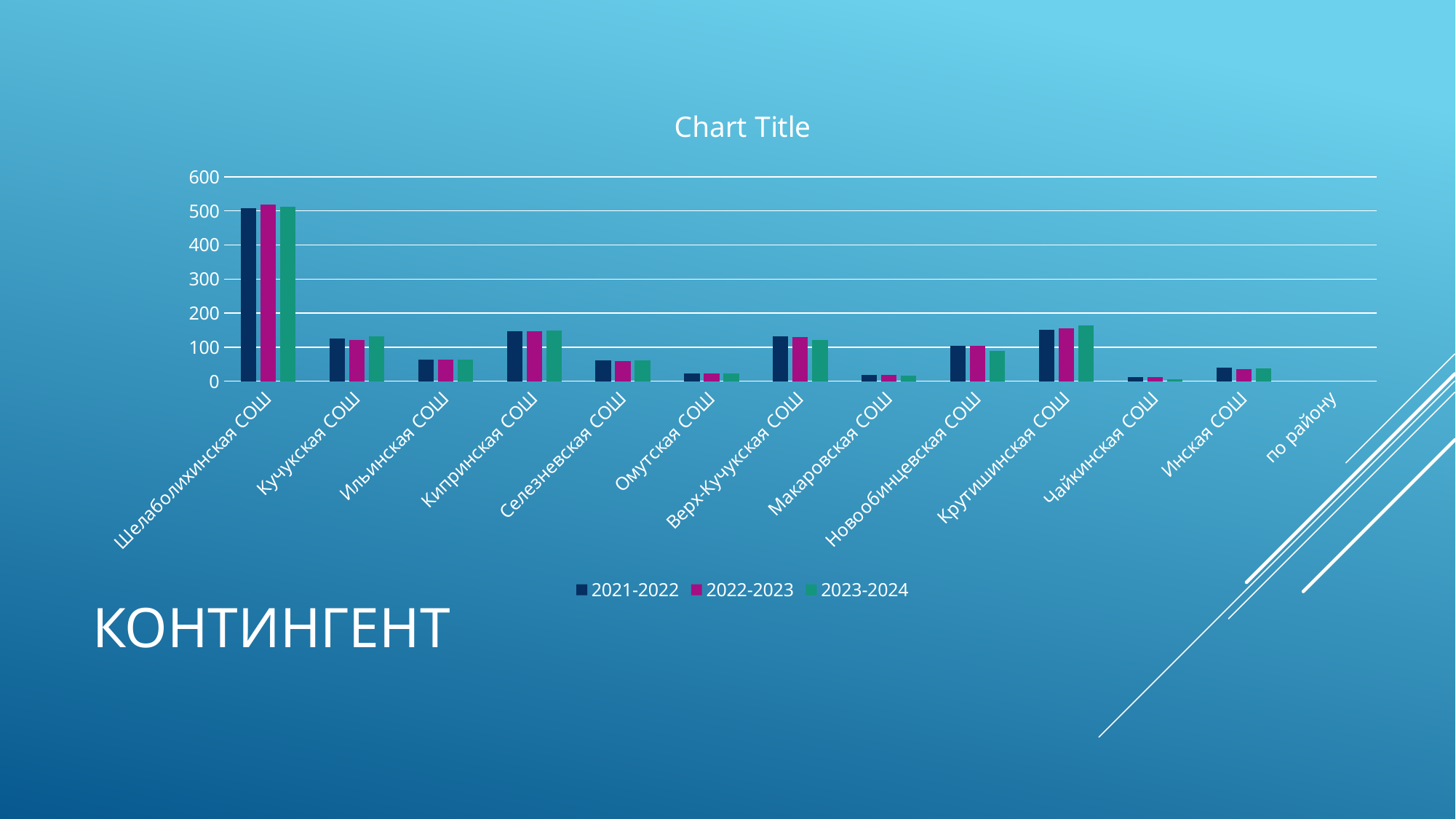
Is the 2022-2023 value for Шелаболихинская СОШ greater or less than 400? greater How many categories are labelled along the x axis? 13 Is the 2021-2022 value for Кипринская СОШ greater or less than 100? greater How many series does the legend list? 3 Is the 2021-2022 value for Ильинская СОШ greater or less than 100? less Which is larger for 2023-2024: Крутишинская СОШ or Кучукская СОШ? Крутишинская СОШ What kind of chart is shown on the slide? bar chart Which category has the highest bars in the chart? Шелаболихинская СОШ What is the title shown above the chart? Chart Title What are the series names listed in the legend? 2021-2022, 2022-2023, 2023-2024 Which is larger for 2021-2022: Кипринская СОШ or Ильинская СОШ? Кипринская СОШ